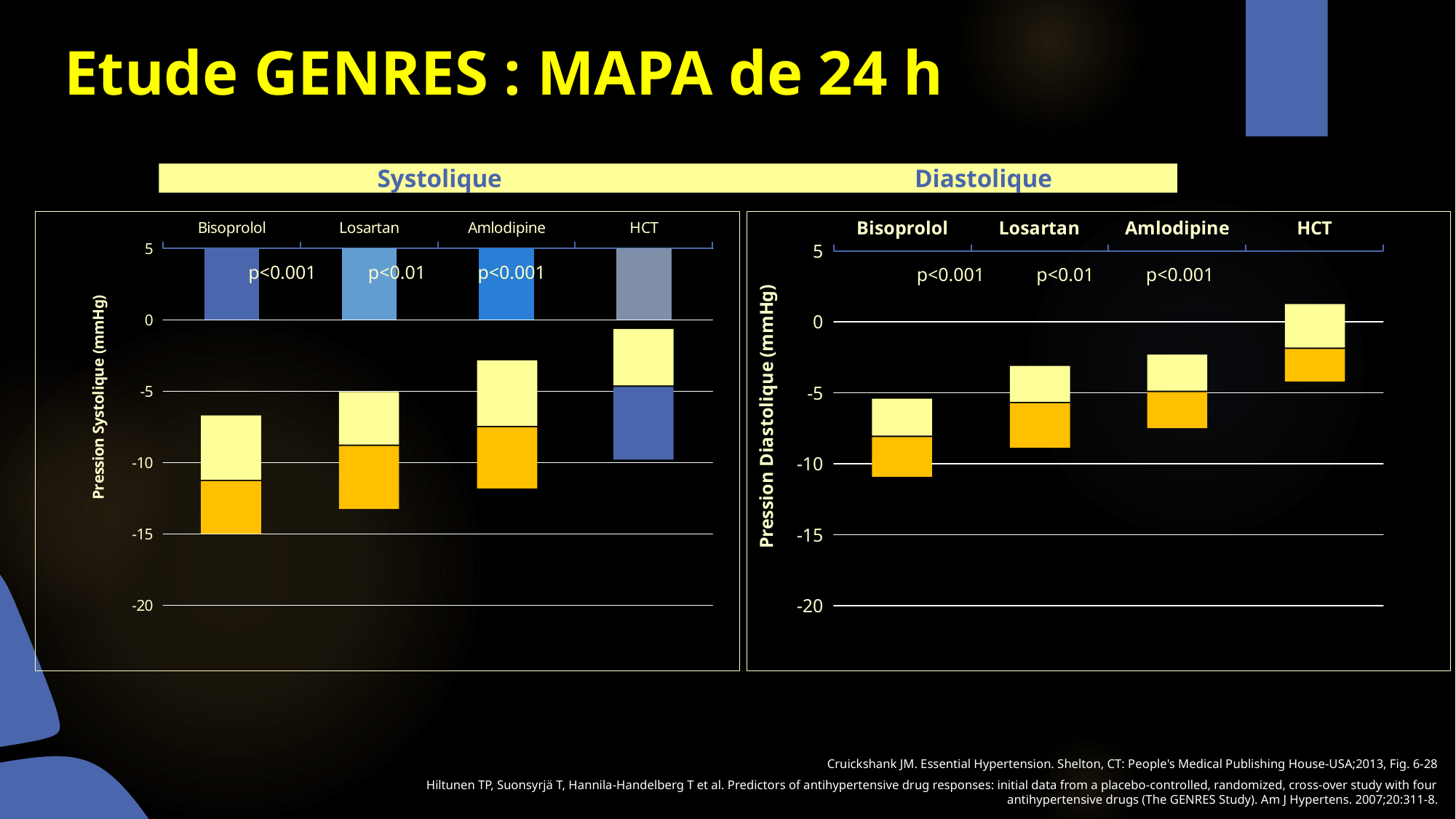
How many drug categories are shown on the x axis of the Systolique chart? 4 In the Systolique chart, is the bottom of the Amlodipine bar greater or less than -15? greater In the Diastolique chart, which drug's bar extends the highest? HCT What is the y-axis label of the Diastolique chart? Pression Diastolique (mmHg) In the Systolique chart, is the bottom of the Bisoprolol bar greater or less than -10? less In the Systolique chart, which bar extends lower, Losartan or HCT? Losartan In the Systolique chart, which drug's bar reaches the lowest value? Bisoprolol What kind of chart is the Diastolique chart? bar chart In the Diastolique chart, which drug's bar reaches the lowest value? Bisoprolol In the Diastolique chart, is the bottom of the HCT bar greater or less than -5? greater What p-value is printed above Losartan in the Systolique chart? p<0.01